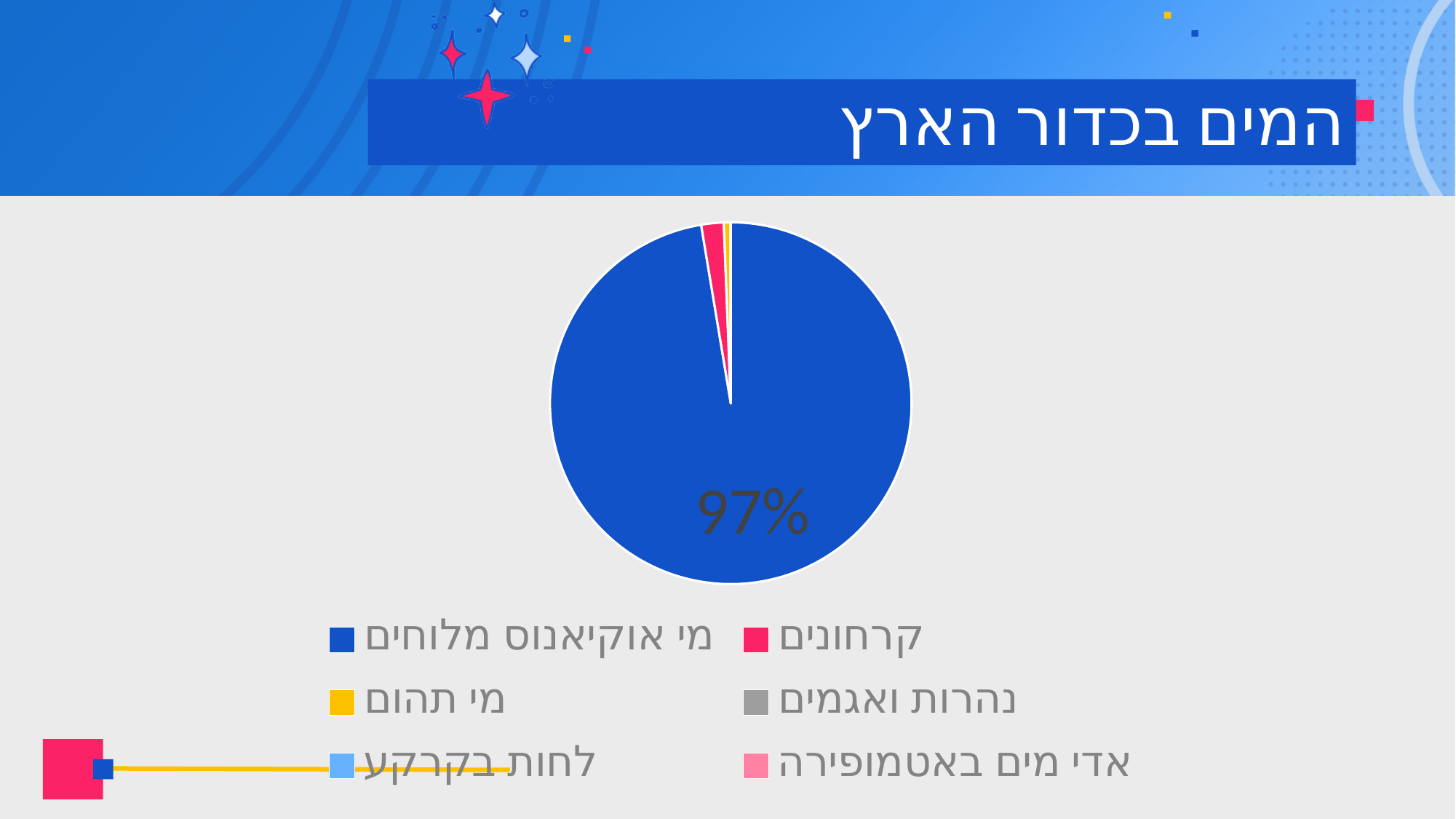
What colour is the slice for מי אוקיאנוס מלוחים? blue What kind of chart is shown on the slide? pie chart Which category has the largest slice of the pie? מי אוקיאנוס מלוחים Which is larger, the slice for קרחונים or the slice for מי תהום? קרחונים How many categories does the legend list? 6 Which category is represented by the yellow legend marker? מי תהום What share of the pie does מי אוקיאנוס מלוחים take? 97% What is the chart title on the slide? המים בכדור הארץ Which is larger, the slice for מי אוקיאנוס מלוחים or the slice for קרחונים? מי אוקיאנוס מלוחים What percentage is shown for מי אוקיאנוס מלוחים? 97%